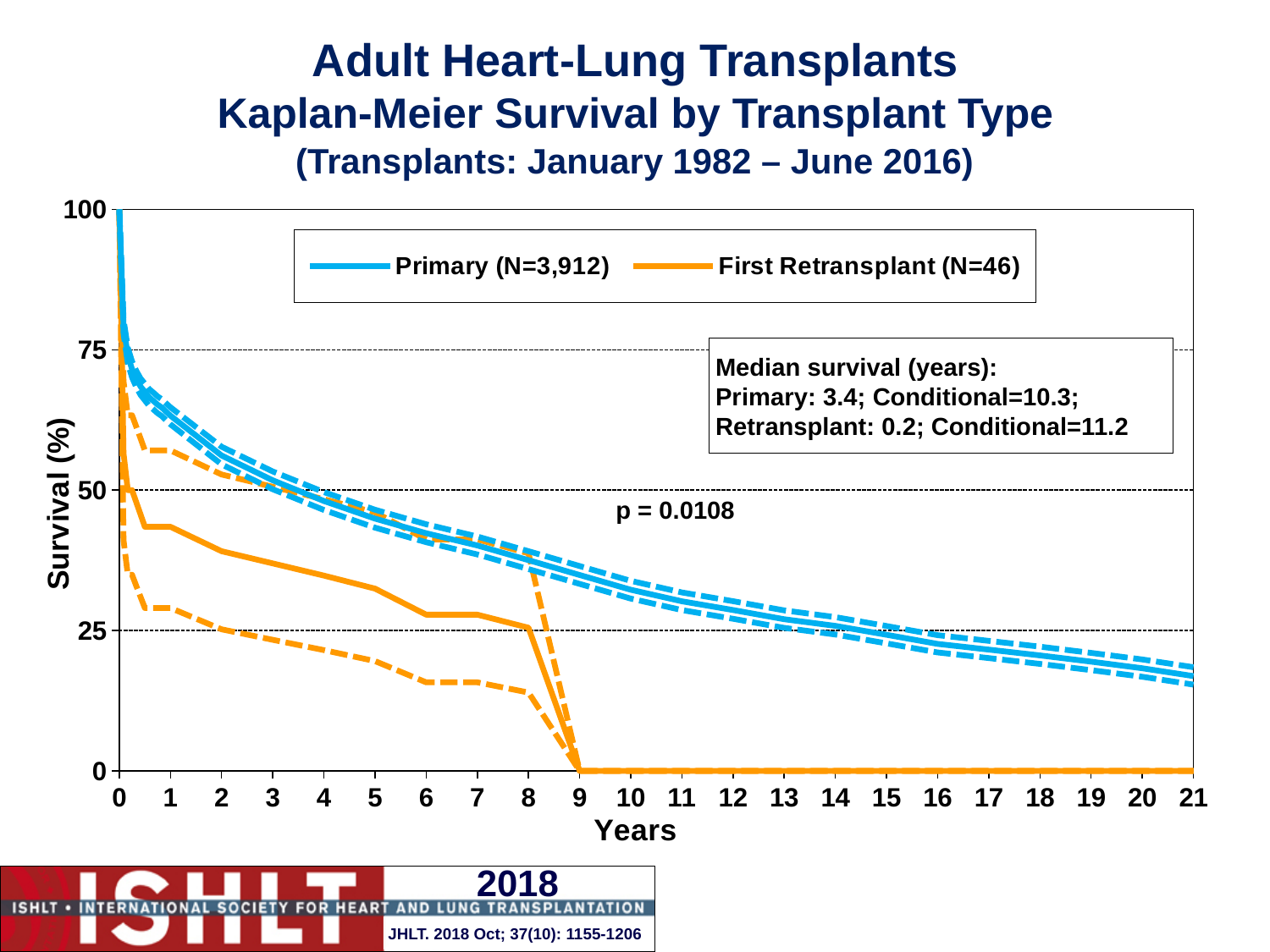
What is the p-value shown on the chart? p = 0.0108 What is the median survival in years for Retransplant? 0.2 How many series does the legend list? 2 What is the number of patients (N) in the First Retransplant group according to the legend? 46 What kind of chart is shown on the slide? Line chart Is the survival for the Primary group at 10 years greater or less than 25? greater What is the number of patients (N) in the Primary group according to the legend? 3,912 What is the difference in median survival (years) between Primary and Retransplant? 3.2 Which group has the higher median survival, Primary or Retransplant? Primary What is the conditional median survival in years for Primary transplants? 10.3 Does survival rise or fall as years increase along the x axis? Fall What is the median survival in years for Primary transplants? 3.4